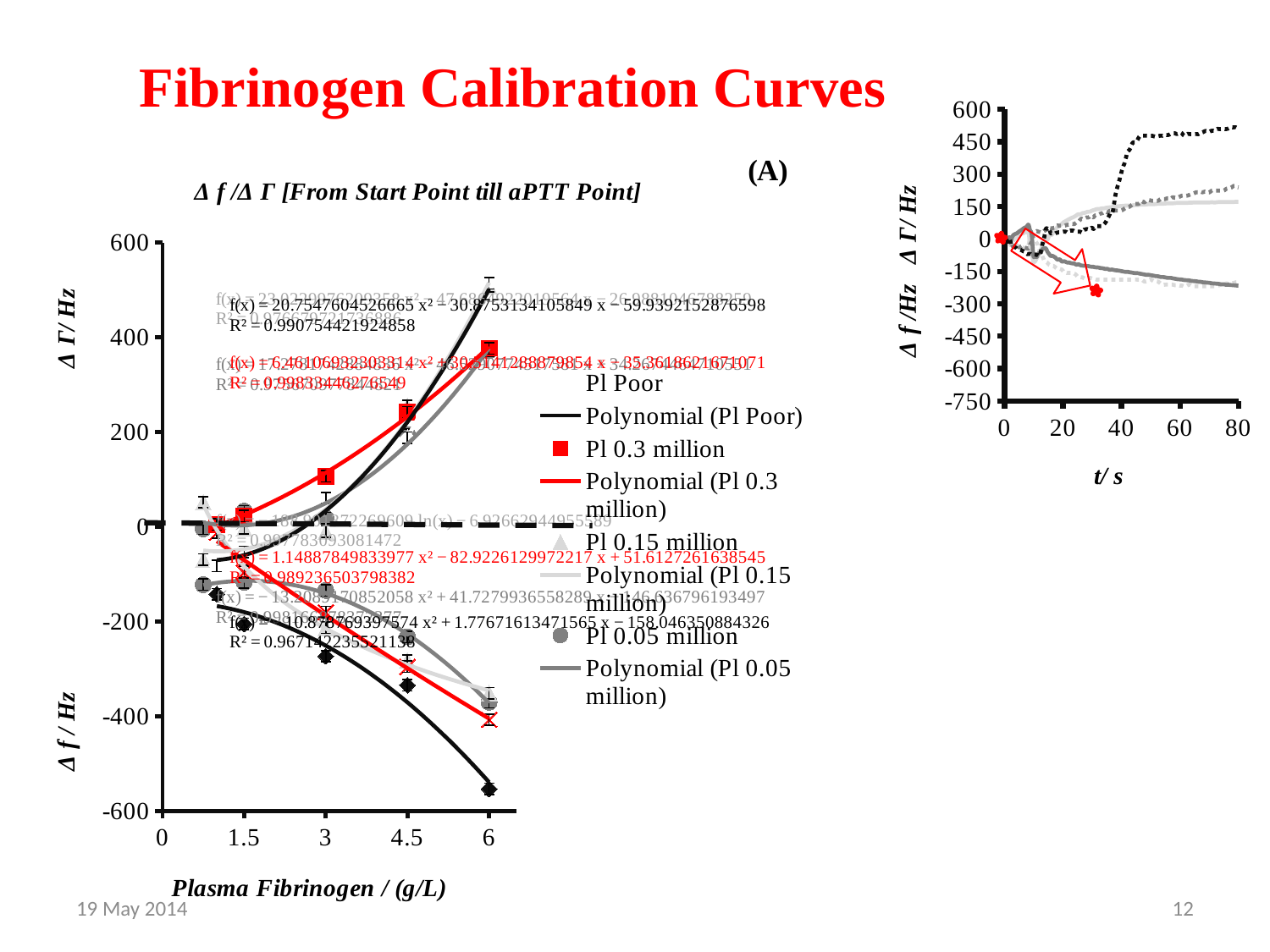
In the main chart, is the lowest Pl Poor point (black diamond) at 6 g/L greater or less than -400? less In the main chart, is the value of the Pl 0.3 million series (red squares) at 6 g/L greater or less than 200? greater What is the x-axis label of the small chart on the right? t/ s What is the lowest tick value on the y-axis of the small chart on the right? -750 In the main chart, does the black Pl Poor polynomial curve in the lower half rise or fall as plasma fibrinogen increases from 1.5 to 6 g/L? fall In the main chart, is the lower Pl 0.05 million point (grey circle) at 6 g/L greater or less than -200? less What is the maximum value shown on the y-axis of the main chart? 600 In the main chart, what is the x-axis label? Plasma Fibrinogen / (g/L) How many entries does the legend of the main chart list? 8 What is the largest tick value on the x-axis of the small chart on the right? 80 In the main chart, does the red Pl 0.3 million series with the rising polynomial curve increase or decrease as plasma fibrinogen increases? increase